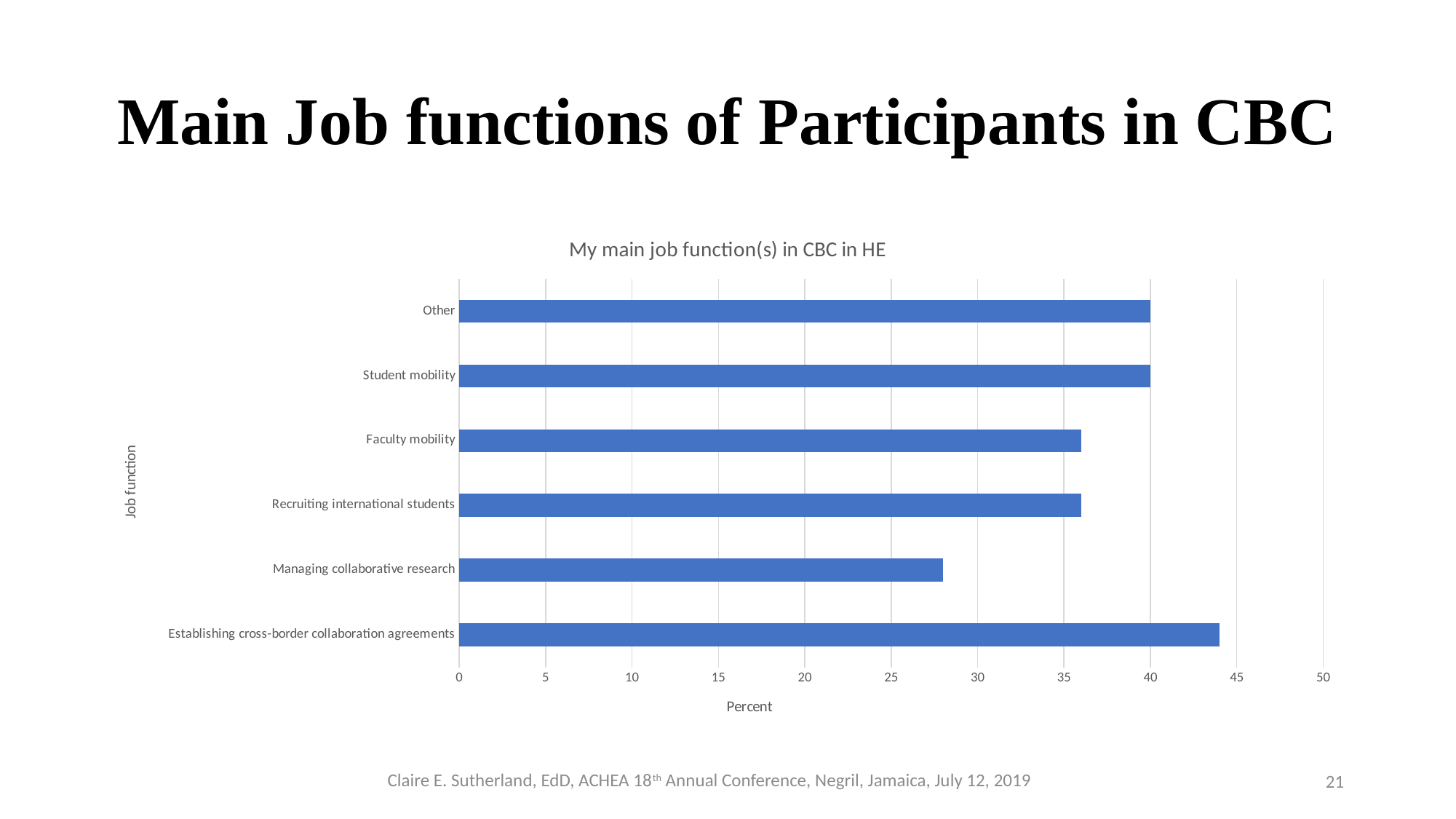
Is the value for Establishing cross-border collaboration agreements greater or less than 40? greater What is the percent value for Other? 40 What is the title of the chart? My main job function(s) in CBC in HE Which job function has the lowest percent? Managing collaborative research How many job function categories are plotted in the chart? 6 What type of chart is shown on the slide? bar chart Which is larger, the value for Faculty mobility or the value for Managing collaborative research? Faculty mobility Which job function has the highest percent? Establishing cross-border collaboration agreements What is the percent value for Student mobility? 40 Is the value for Managing collaborative research greater or less than 30? less What is the label of the horizontal axis? Percent Is the value for Faculty mobility greater or less than 35? greater